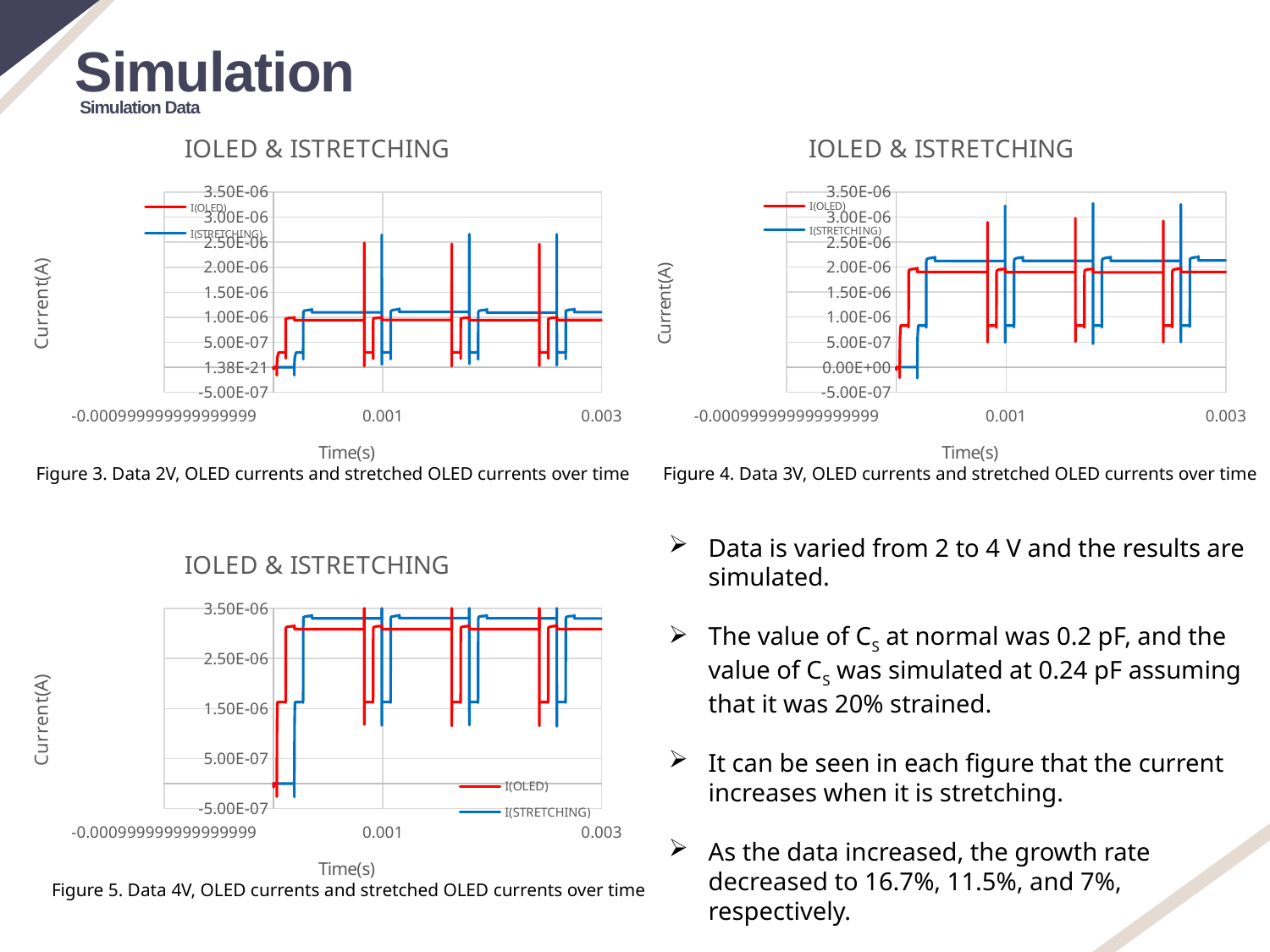
In the top-right chart (Figure 4, Data 3V), are the peak spikes of I(STRETCHING) greater or less than 3.00E-06? greater In the top-right chart (Figure 4, Data 3V), which series reaches the higher peak current, I(OLED) or I(STRETCHING)? I(STRETCHING) In the bottom-left chart (Figure 5, Data 4V), which series has the higher steady-state current, I(OLED) or I(STRETCHING)? I(STRETCHING) In the bottom-left chart (Figure 5, Data 4V), is the steady-state value of I(OLED) greater or less than 2.50E-06? greater In the top-left chart (Figure 3, Data 2V), is the steady-state value of I(STRETCHING) greater or less than 1.00E-06? greater What kind of chart is the top-left chart (Figure 3, Data 2V)? line chart What is the y-axis label of the top-left chart (Figure 3, Data 2V)? Current(A) How many series does the legend of the top-right chart (Figure 4, Data 3V) list? 2 What is the largest tick value shown on the x-axis of the bottom-left chart (Figure 5, Data 4V)? 0.003 What are the two series named in the legend of the bottom-left chart (Figure 5, Data 4V)? I(OLED) and I(STRETCHING)